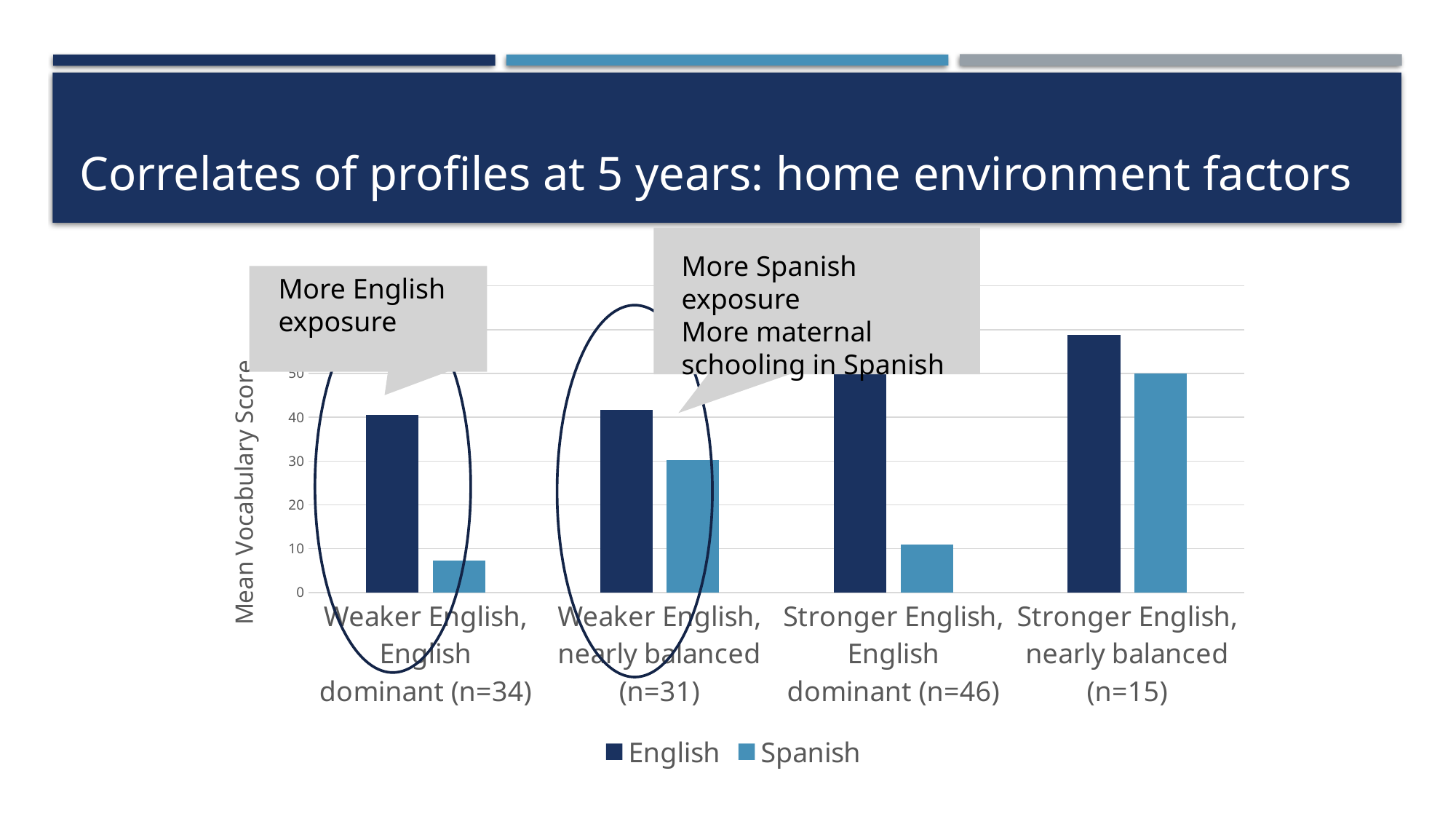
Which category has the lowest Spanish mean vocabulary score? Weaker English, English dominant (n=34) Is the Spanish value for Weaker English, nearly balanced (n=31) greater or less than 20? greater What kind of chart is shown on the slide? bar chart How many series does the legend list? 2 How many language profile categories are shown on the x axis? 4 Is the Spanish value for Weaker English, English dominant (n=34) greater or less than 10? less Is the English value for Stronger English, nearly balanced (n=15) greater or less than 50? greater For Stronger English, English dominant (n=46), which is larger: the English or the Spanish score? English Which series is shown in the lighter blue colour? Spanish What is the label of the vertical axis? Mean Vocabulary Score